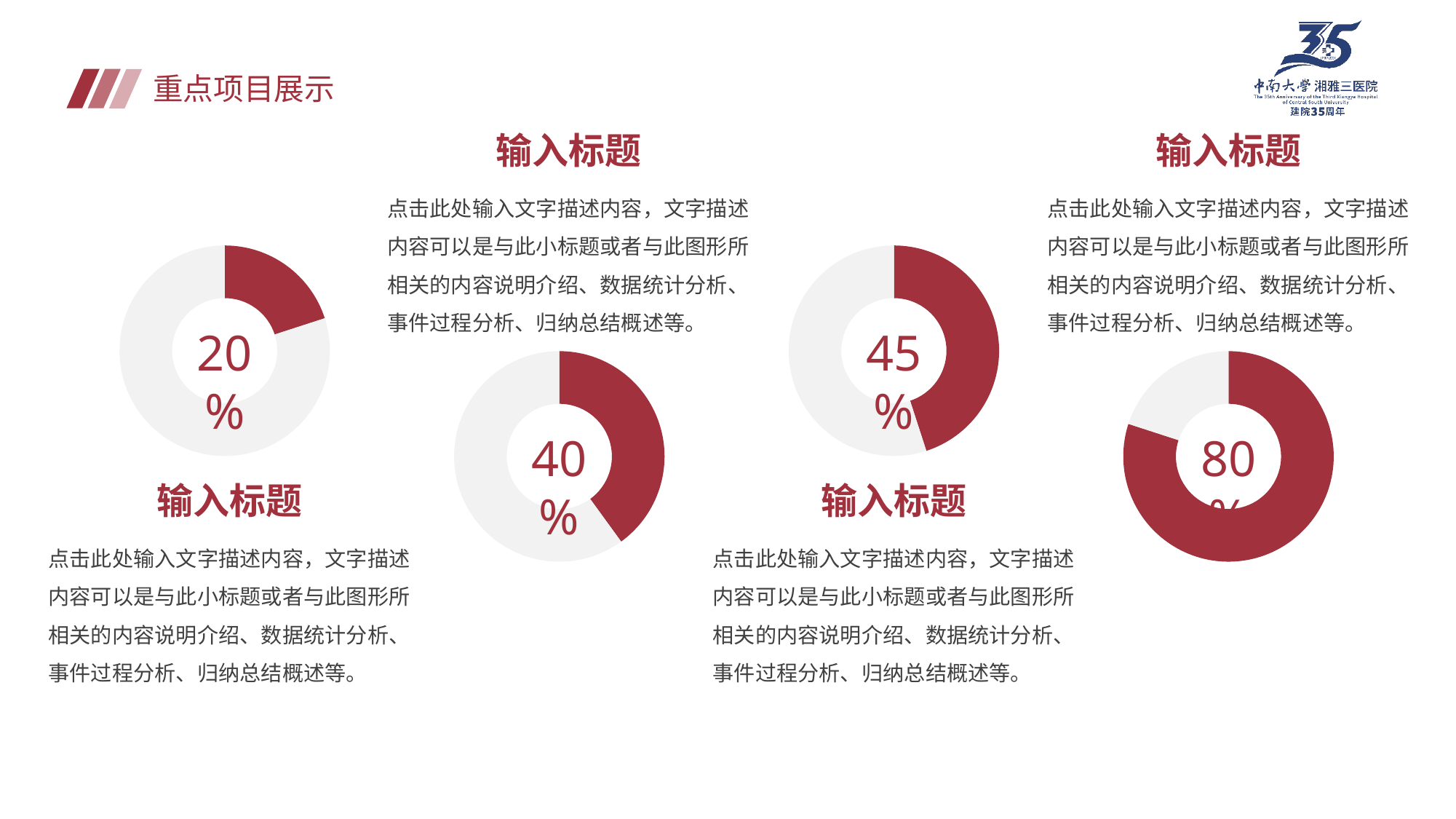
What colour is the filled portion of each donut chart? Dark red What kind of chart is used to display the percentages on this slide? Donut chart Which donut chart on the slide shows the highest percentage? The rightmost one (80%) What value is shown in the centre of the third donut chart from the left? 45% What is the difference between the values of the third and second donut charts from the left? 5% How many donut charts are on the slide? 4 What value is shown in the centre of the leftmost donut chart? 20% What value is shown in the centre of the second donut chart from the left? 40% What is the difference between the value in the rightmost donut chart and the value in the leftmost donut chart? 60% Which is larger: the value in the second donut chart from the left or the value in the third donut chart from the left? The third (45%) Which donut chart on the slide shows the lowest percentage? The leftmost one (20%) What value is shown in the centre of the rightmost donut chart? 80%